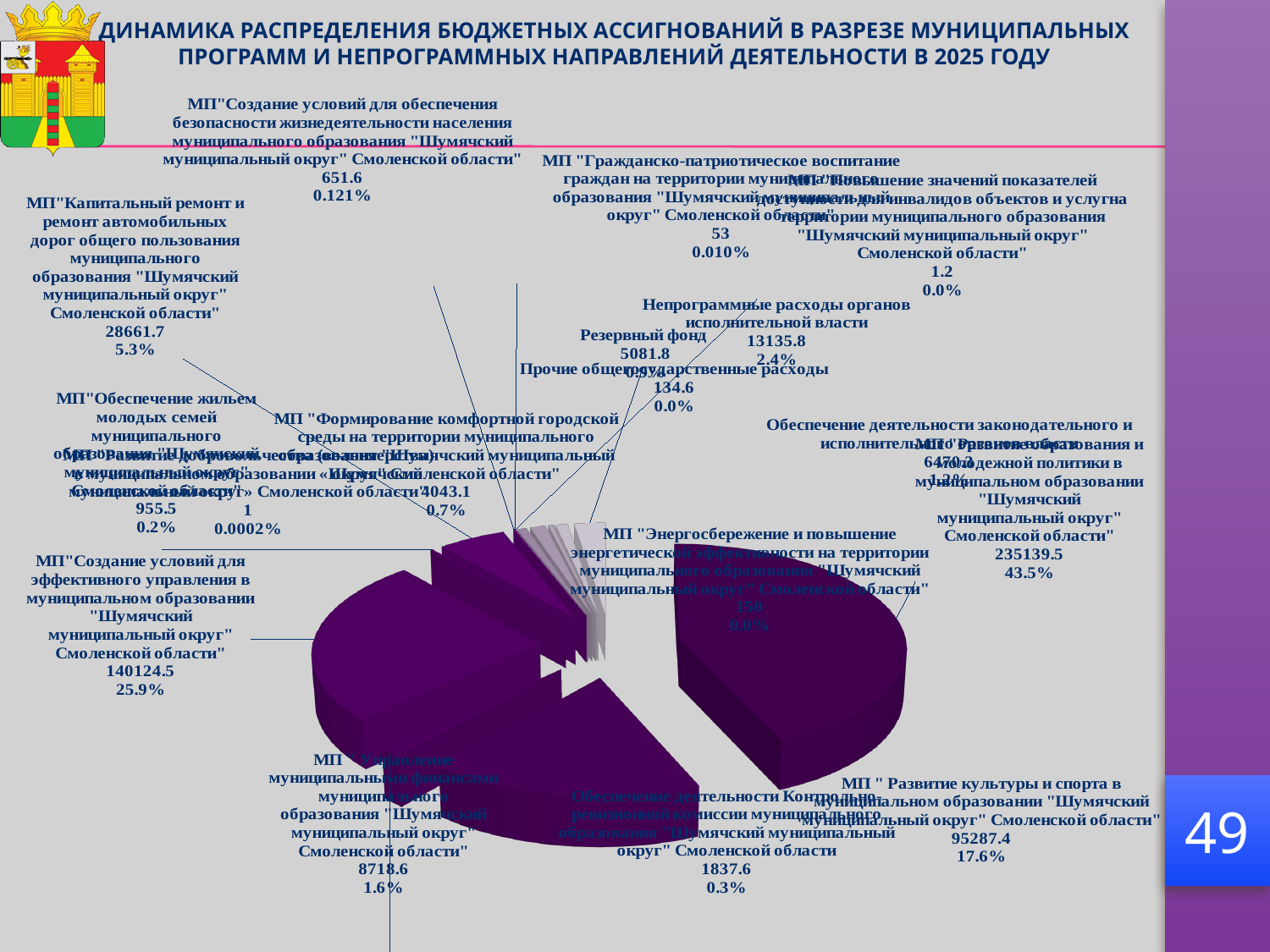
Which year does the slide title say the budget allocation dynamics refer to? 2025 Which category has the largest share of the pie? МП "Развитие образования и молодежной политики в муниципальном образовании "Шумячский муниципальный округ" Смоленской области" What value is shown for МП "Развитие образования и молодежной политики в муниципальном образовании "Шумячский муниципальный округ" Смоленской области"? 235139.5 Which is larger: the value for МП "Капитальный ремонт и ремонт автомобильных дорог общего пользования" or the value for Непрограммные расходы органов исполнительной власти? МП "Капитальный ремонт и ремонт автомобильных дорог общего пользования" What value is shown for МП "Гражданско-патриотическое воспитание граждан на территории муниципального образования"? 53 What share of the pie does МП "Развитие образования и молодежной политики" account for? 43.5% What value is shown for МП "Создание условий для эффективного управления в муниципальном образовании "Шумячский муниципальный округ" Смоленской области"? 140124.5 What kind of chart is shown on the slide? pie chart What value is shown for Обеспечение деятельности Контрольно-ревизионной комиссии муниципального образования "Шумячский муниципальный округ" Смоленской области? 1837.6 What is the difference between the value for МП "Развитие образования и молодежной политики" (235139.5) and the value for МП "Создание условий для эффективного управления" (140124.5)? 95015.0 What value is shown for МП "Управление муниципальными финансами муниципального образования "Шумячский муниципальный округ" Смоленской области"? 8718.6 What percentage is shown for МП "Развитие культуры и спорта в муниципальном образовании "Шумячский муниципальный округ" Смоленской области"? 17.6%